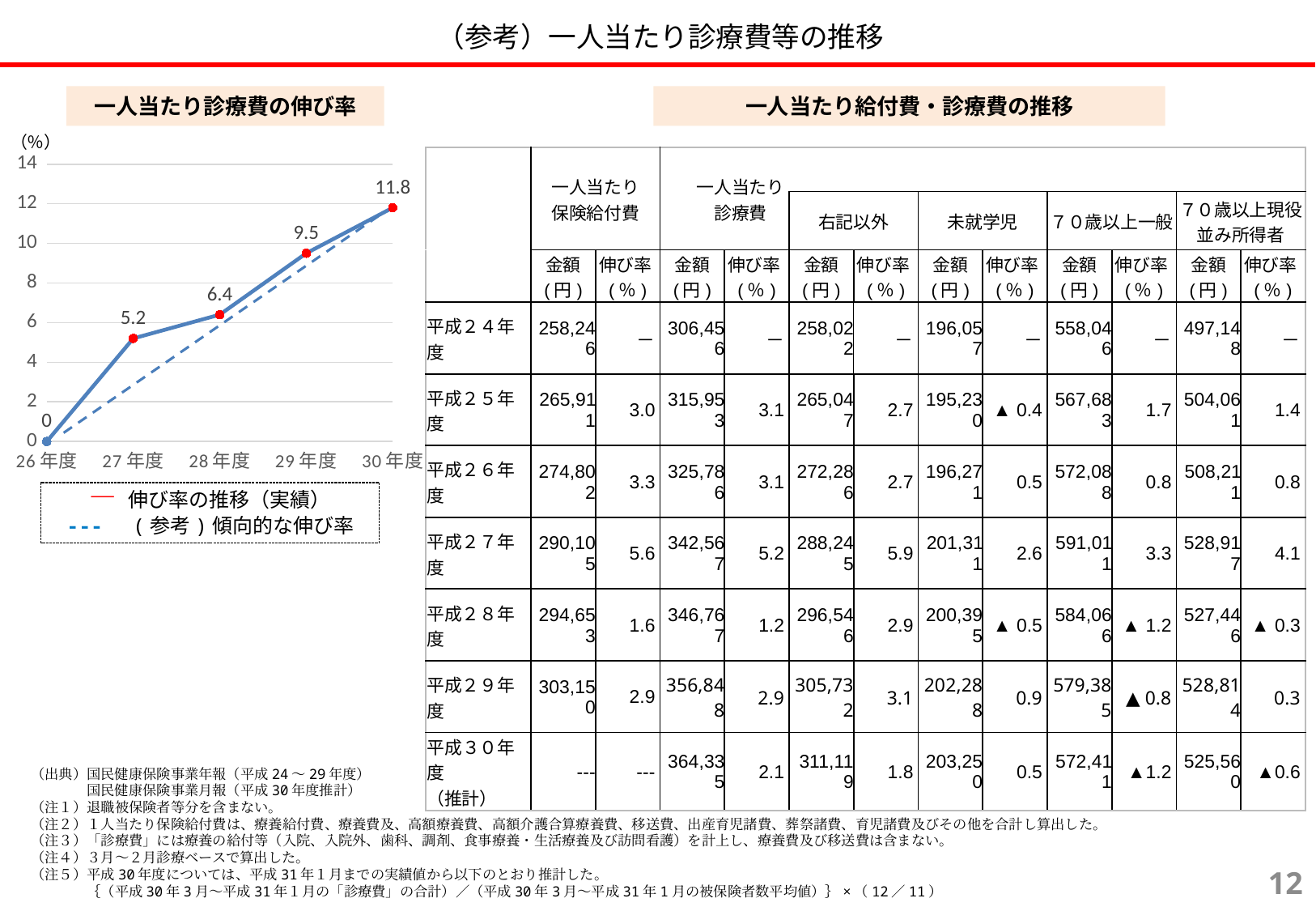
In the 一人当たり診療費の伸び率 chart, what is the difference between the 30年度 and 29年度 values on the 伸び率の推移（実績） line? 2.3 In the 一人当たり診療費の伸び率 chart, how many years are shown on the x axis? 5 In the 一人当たり診療費の伸び率 chart, what is the value for 29年度 on the 伸び率の推移（実績） line? 9.5 In the 一人当たり診療費の伸び率 chart, which year has the lowest value on the 伸び率の推移（実績） line? 26年度 In the 一人当たり診療費の伸び率 chart, what is the value for 28年度 on the 伸び率の推移（実績） line? 6.4 How many series does the legend of the 一人当たり診療費の伸び率 chart list? 2 In the 一人当たり診療費の伸び率 chart, which is larger on the 伸び率の推移（実績） line: 27年度 or 28年度? 28年度 In the 一人当たり診療費の伸び率 chart, what is the value for 30年度 on the 伸び率の推移（実績） line? 11.8 In the 一人当たり診療費の伸び率 chart, which year has the highest value on the 伸び率の推移（実績） line? 30年度 What type of chart is shown on the left of the slide under 一人当たり診療費の伸び率? line chart In the 一人当たり診療費の伸び率 chart, do the values on the 伸び率の推移（実績） line rise or fall from 26年度 to 30年度? rise In the 一人当たり診療費の伸び率 chart, what is the value for 27年度 on the 伸び率の推移（実績） line? 5.2